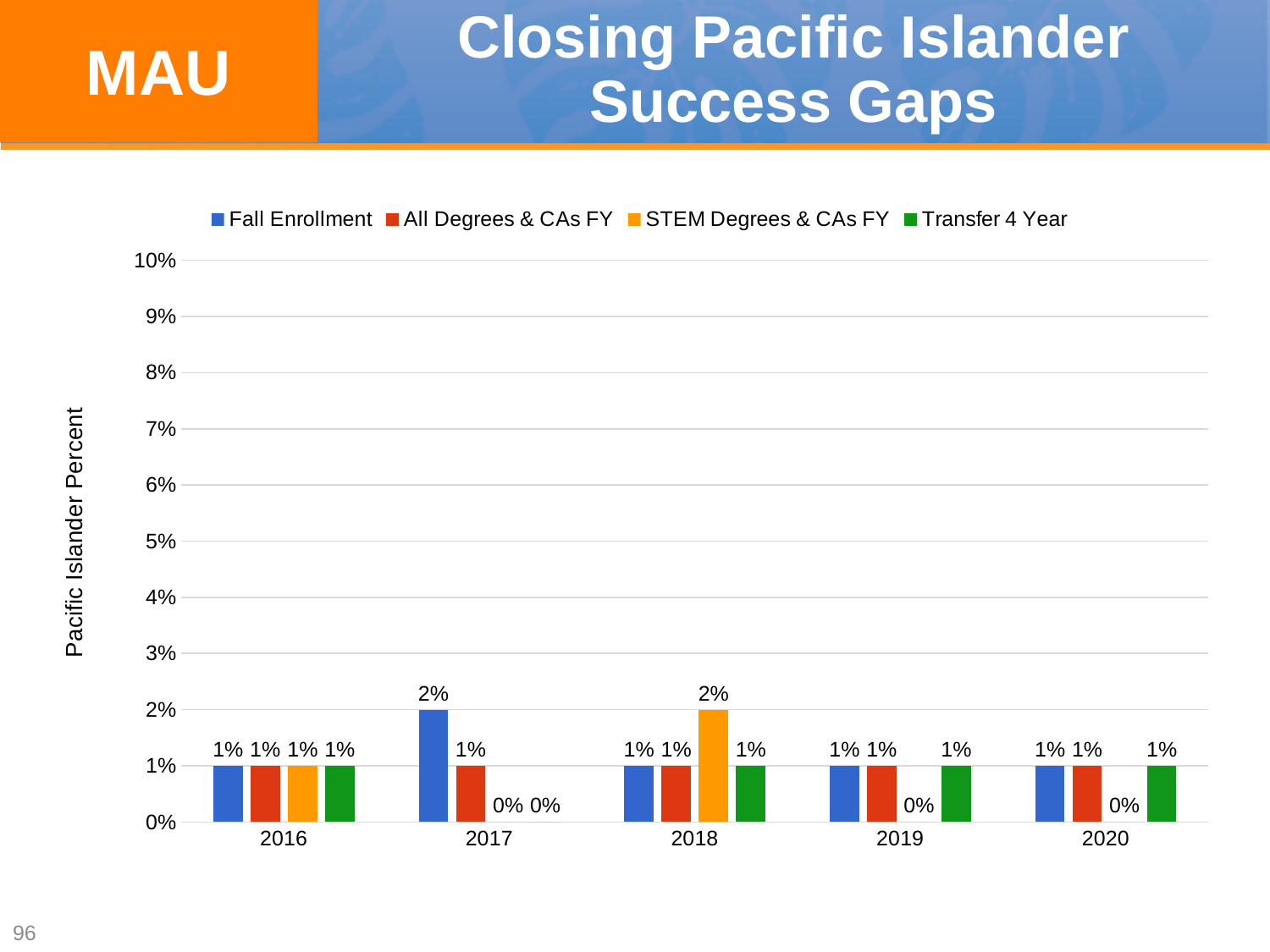
What kind of chart is shown on the slide? Bar chart How many series does the legend list? 4 What is the difference between the Fall Enrollment value and the All Degrees & CAs FY value in 2017? 1% In 2018, which is larger: STEM Degrees & CAs FY or Transfer 4 Year? STEM Degrees & CAs FY What is the STEM Degrees & CAs FY value for 2019? 0% What is the Fall Enrollment value for 2016? 1% What is the Transfer 4 Year value for 2017? 0% In which year is the STEM Degrees & CAs FY value highest? 2018 What is the STEM Degrees & CAs FY value for 2018? 2% How many years are shown on the x axis? 5 What is the Fall Enrollment value for 2017? 2% In which year is the Fall Enrollment value highest? 2017